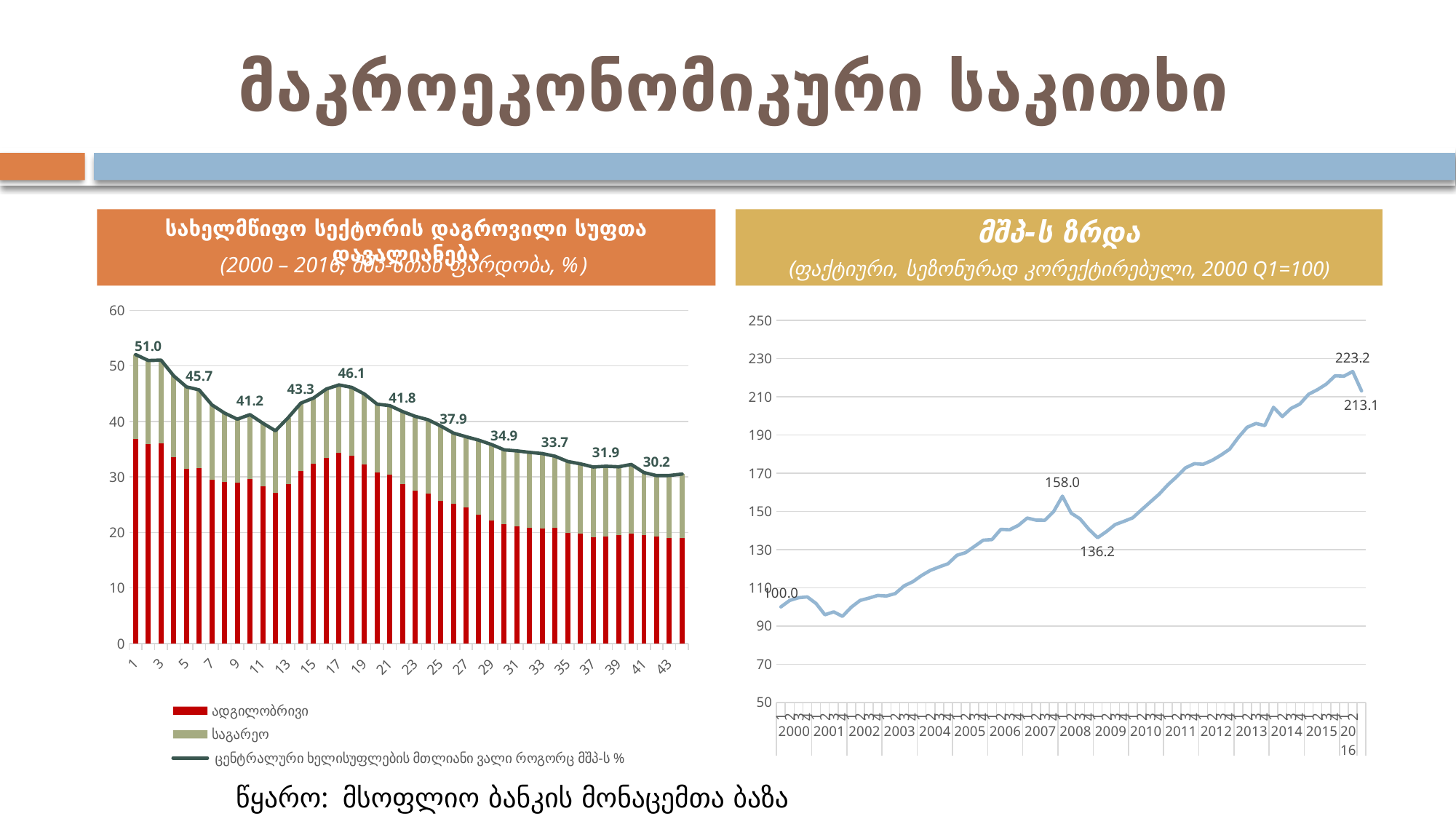
What type of chart is the left-hand chart? combination bar and line chart On the right-hand chart, does the line generally rise or fall from 2000 to 2016? rise What type of chart is the right-hand chart (მშპ-ს ზრდა)? line chart On the left-hand chart, what is the first labelled value of the total debt line? 51.0 On the right-hand chart, what is the value labelled at the start of the series in 2000? 100.0 On the right-hand chart, what is the highest labelled value? 223.2 On the right-hand chart, what is the difference between the 2008 peak labelled 158.0 and the following trough labelled 136.2? 21.8 On the right-hand chart, what is the difference between the labelled peak of 223.2 and the final value of 213.1? 10.1 On the right-hand chart, is the lowest point of the line (around 2001) greater or less than 100? less On the right-hand chart, what is the last labelled value at the end of the series? 213.1 On the left-hand chart, what is the last labelled value of the total debt line? 30.2 How many series does the legend of the left-hand chart list? 3